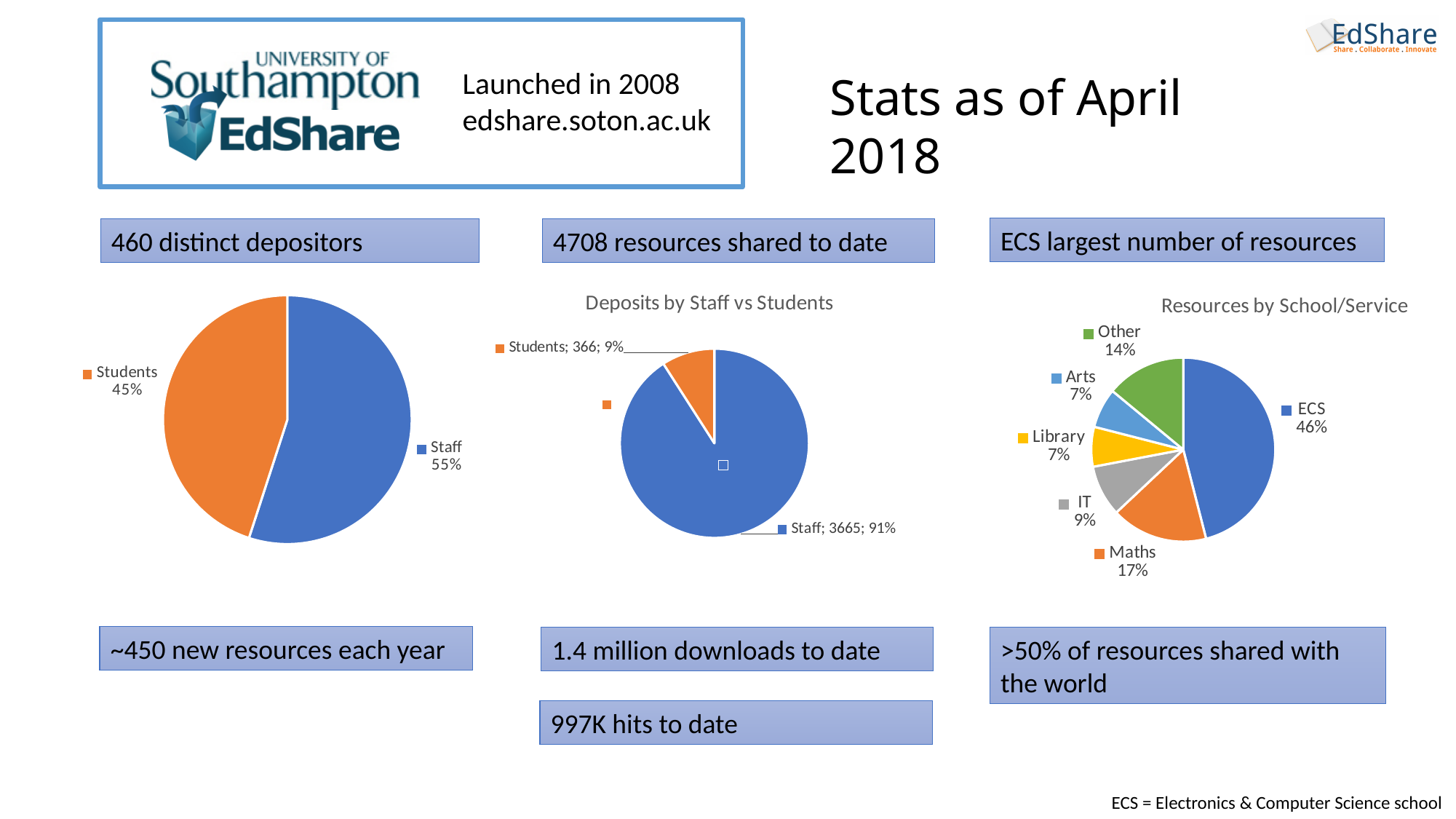
In the 'Resources by School/Service' chart, what share is labelled for Maths? 17% In the left-hand pie chart (under '460 distinct depositors'), which slice is larger, Staff or Students? Staff In the 'Resources by School/Service' chart, how many slices are there? 6 In the 'Resources by School/Service' chart, what is the difference in percentage points between ECS and Other? 32 In the left-hand pie chart (under '460 distinct depositors'), what share is labelled for Students? 45% What type of chart is 'Resources by School/Service'? Pie chart In the 'Deposits by Staff vs Students' chart, how many deposits are labelled for Staff? 3665 In the 'Deposits by Staff vs Students' chart, how many deposits are labelled for Students? 366 In the 'Deposits by Staff vs Students' chart, what percentage share is labelled for Students? 9% In the 'Deposits by Staff vs Students' chart, what is the difference between the Staff and Students deposit counts? 3299 In the 'Resources by School/Service' chart, which school/service has the largest share? ECS